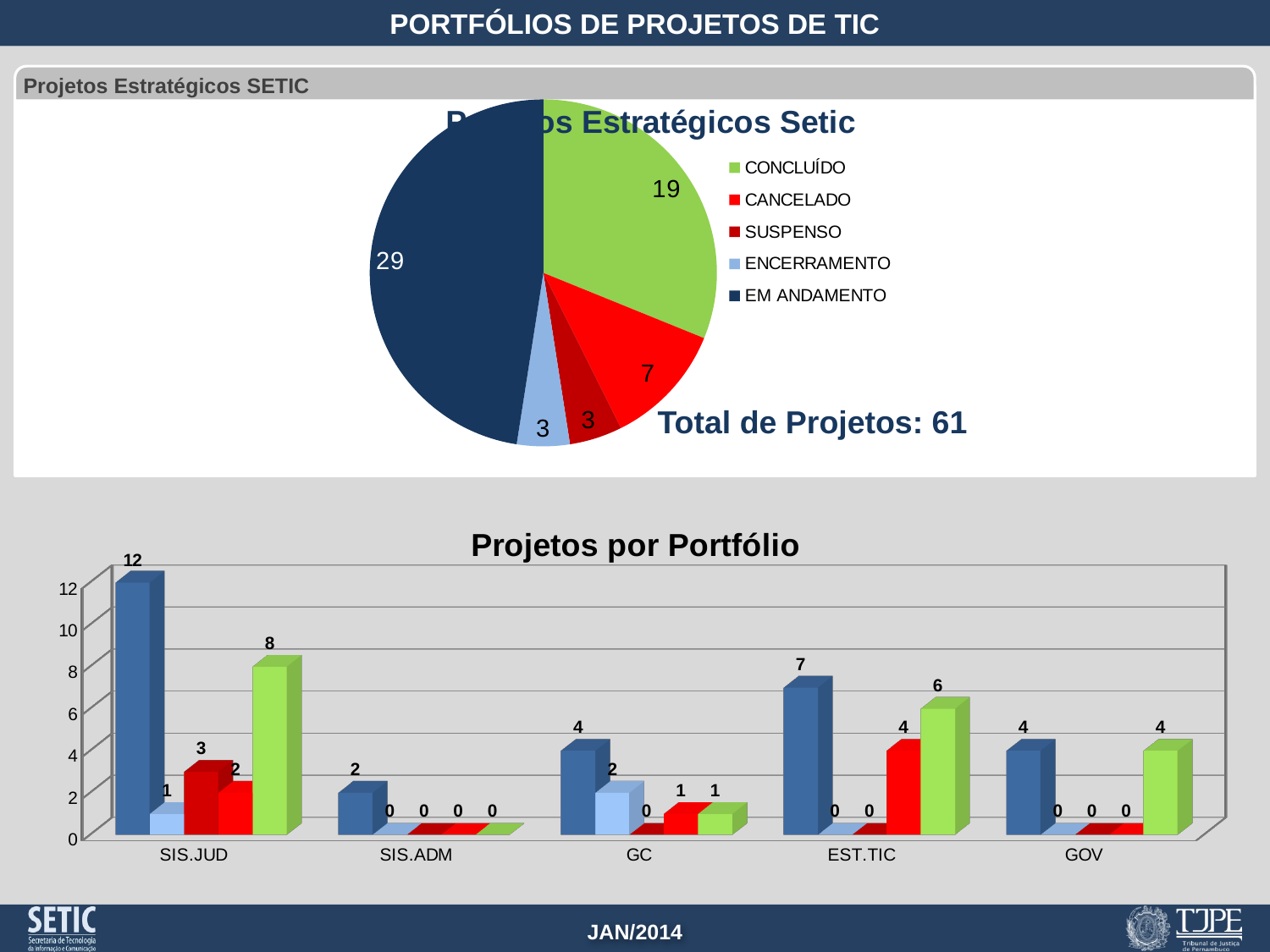
In the chart 'Projetos por Portfólio', what is the value of the green bar for EST.TIC? 6 In the pie chart 'Projetos Estratégicos Setic', which category has the largest slice? EM ANDAMENTO In the pie chart 'Projetos Estratégicos Setic', what is the value for CONCLUÍDO? 19 In the pie chart 'Projetos Estratégicos Setic', what is the difference between the EM ANDAMENTO value and the CONCLUÍDO value? 10 In the pie chart 'Projetos Estratégicos Setic', what is the value for ENCERRAMENTO? 3 In the pie chart 'Projetos Estratégicos Setic', what is the value for CANCELADO? 7 According to the text next to the pie chart 'Projetos Estratégicos Setic', what is the total number of projects? 61 How many categories are shown on the x axis of the chart 'Projetos por Portfólio'? 5 In the chart 'Projetos por Portfólio', which category has the taller dark blue bar, SIS.JUD or EST.TIC? SIS.JUD How many categories does the legend of the pie chart 'Projetos Estratégicos Setic' list? 5 What kind of chart is 'Projetos por Portfólio'? bar chart In the chart 'Projetos por Portfólio', what is the value of the tallest bar for SIS.JUD? 12